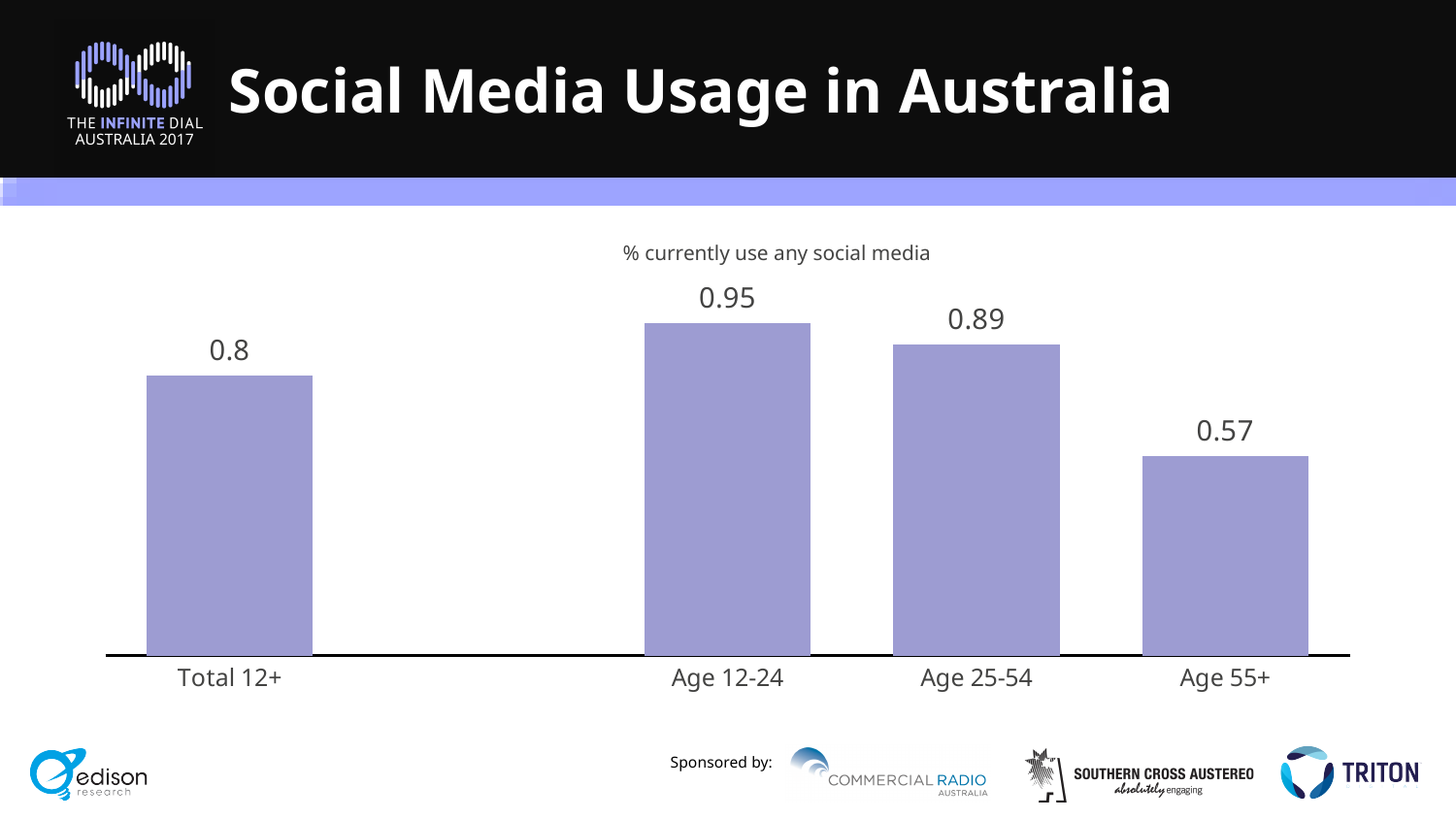
What is the difference between the values for Age 12-24 and Age 55+? 0.38 What is the value for Age 25-54? 0.89 What is the value for Total 12+? 0.8 Which category has the highest value? Age 12-24 Which category has the lowest value? Age 55+ What is the subtitle shown above the chart? % currently use any social media What kind of chart is shown on the slide? Bar chart What is the value for Age 55+? 0.57 Which is larger, the value for Age 25-54 or the value for Total 12+? Age 25-54 How many categories are shown in the chart? 4 What is the difference between the values for Age 25-54 and Total 12+? 0.09 What is the value for Age 12-24? 0.95